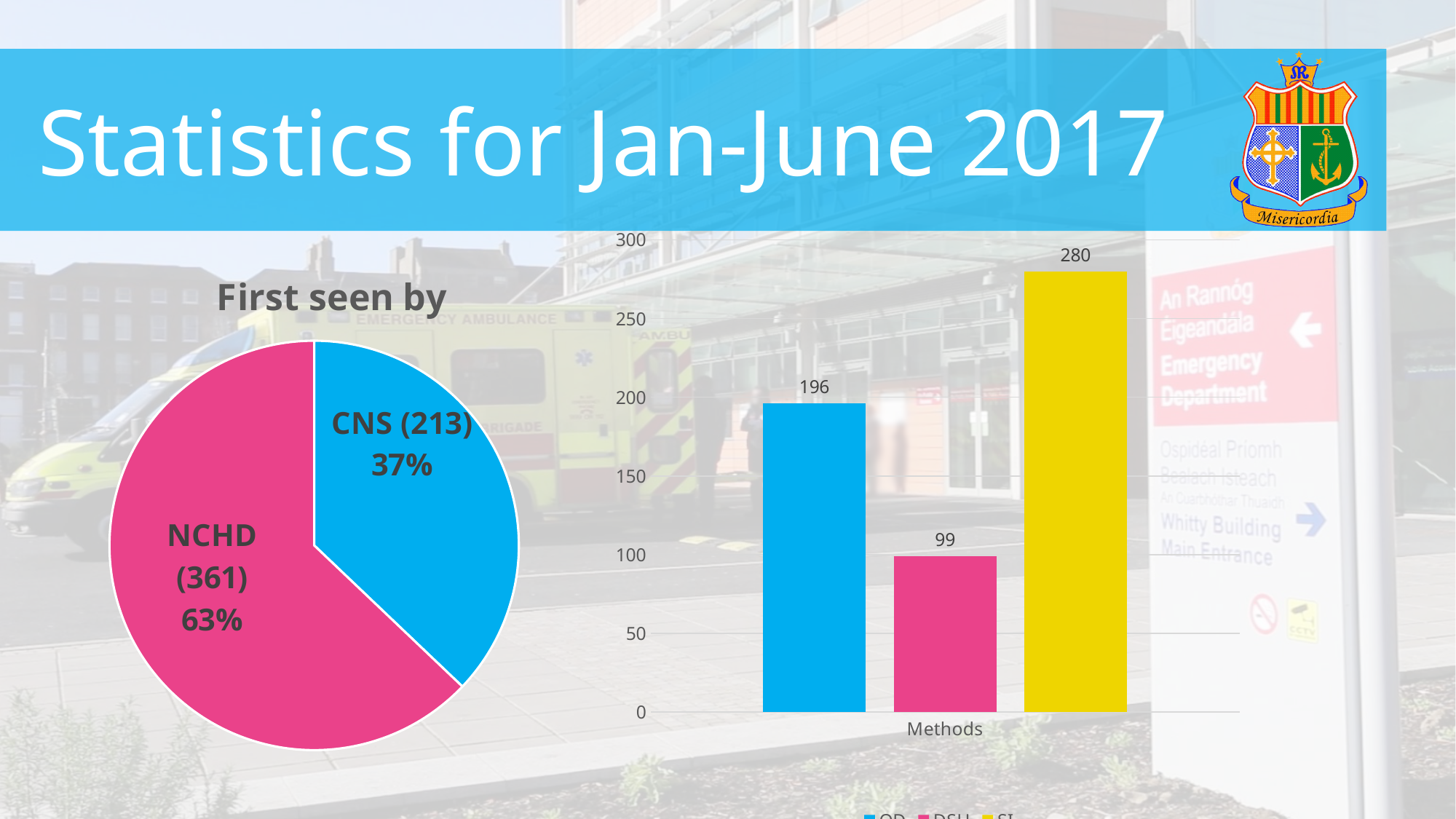
In the pie chart titled 'First seen by', which category has the larger slice? NCHD In the pie chart titled 'First seen by', how many slices are there? 2 In the pie chart titled 'First seen by', what is the difference between the NCHD count and the CNS count? 148 In the pie chart titled 'First seen by', what percentage is shown for CNS? 37% In the bar chart on the right, what is the value of the pink bar? 99 What kind of chart is the chart on the right of the slide with the x-axis label 'Methods'? bar chart In the bar chart on the right, is the value of the blue bar greater or less than 150? greater In the bar chart on the right, what is the difference between the yellow bar and the blue bar? 84 In the pie chart titled 'First seen by', what is the number shown for NCHD? 361 In the bar chart on the right, what is the value of the yellow bar? 280 In the pie chart titled 'First seen by', what percentage is shown for NCHD? 63% In the bar chart on the right, which bar is the lowest? the pink bar (99)